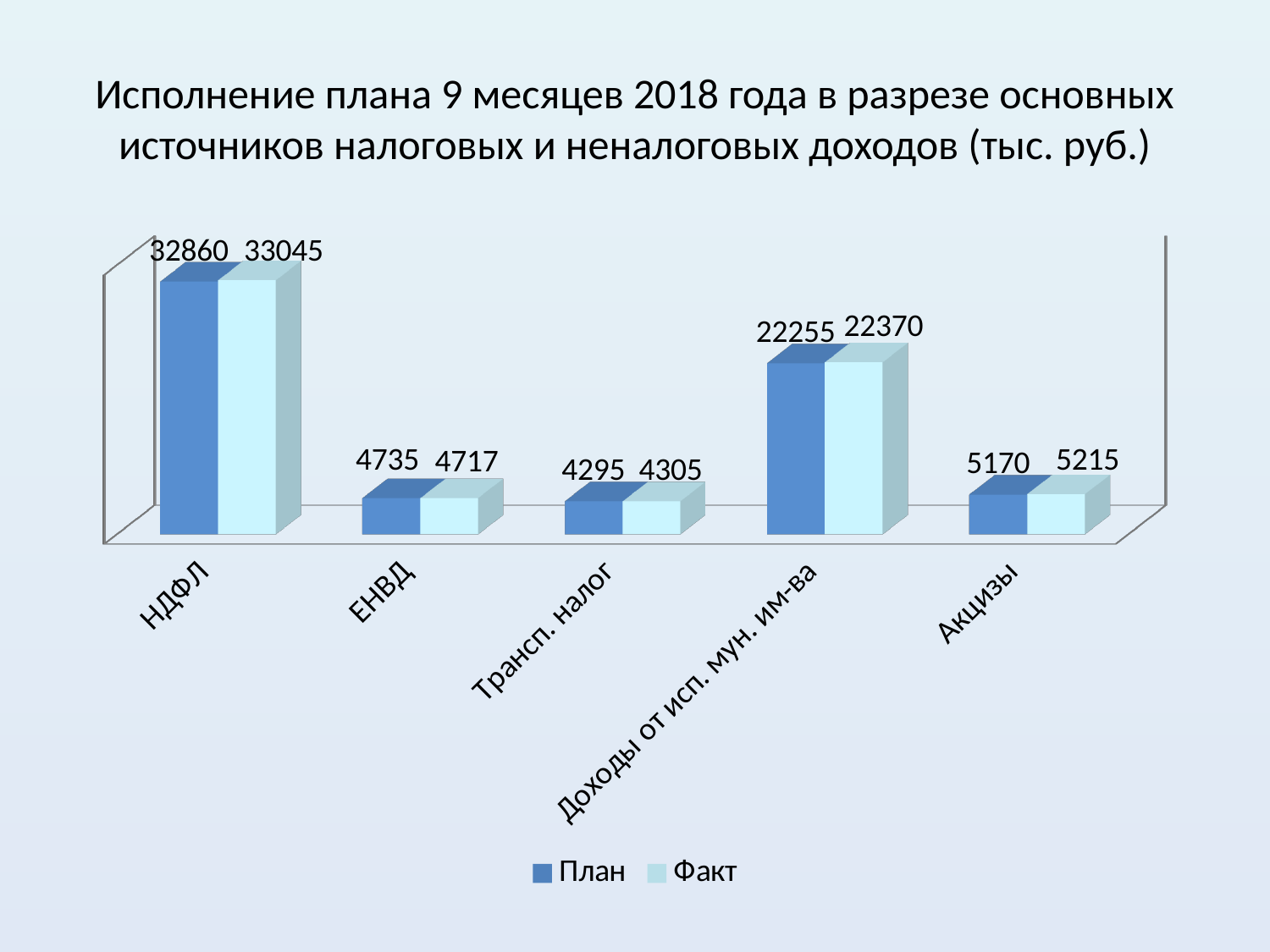
What is the difference between the Факт and План values for НДФЛ? 185 What is the Факт value for ЕНВД? 4717 What is the План value for Акцизы? 5170 What is the План value for НДФЛ? 32860 What kind of chart is shown on the slide? Bar chart Which category has the highest Факт value? НДФЛ What is the difference between the План and Факт values for ЕНВД? 18 How many series does the legend list? 2 Which category has the lowest План value? Трансп. налог What is the Факт value for Доходы от исп. мун. им-ва? 22370 Which is larger for Акцизы, the План value or the Факт value? Факт How many categories are shown on the x axis? 5